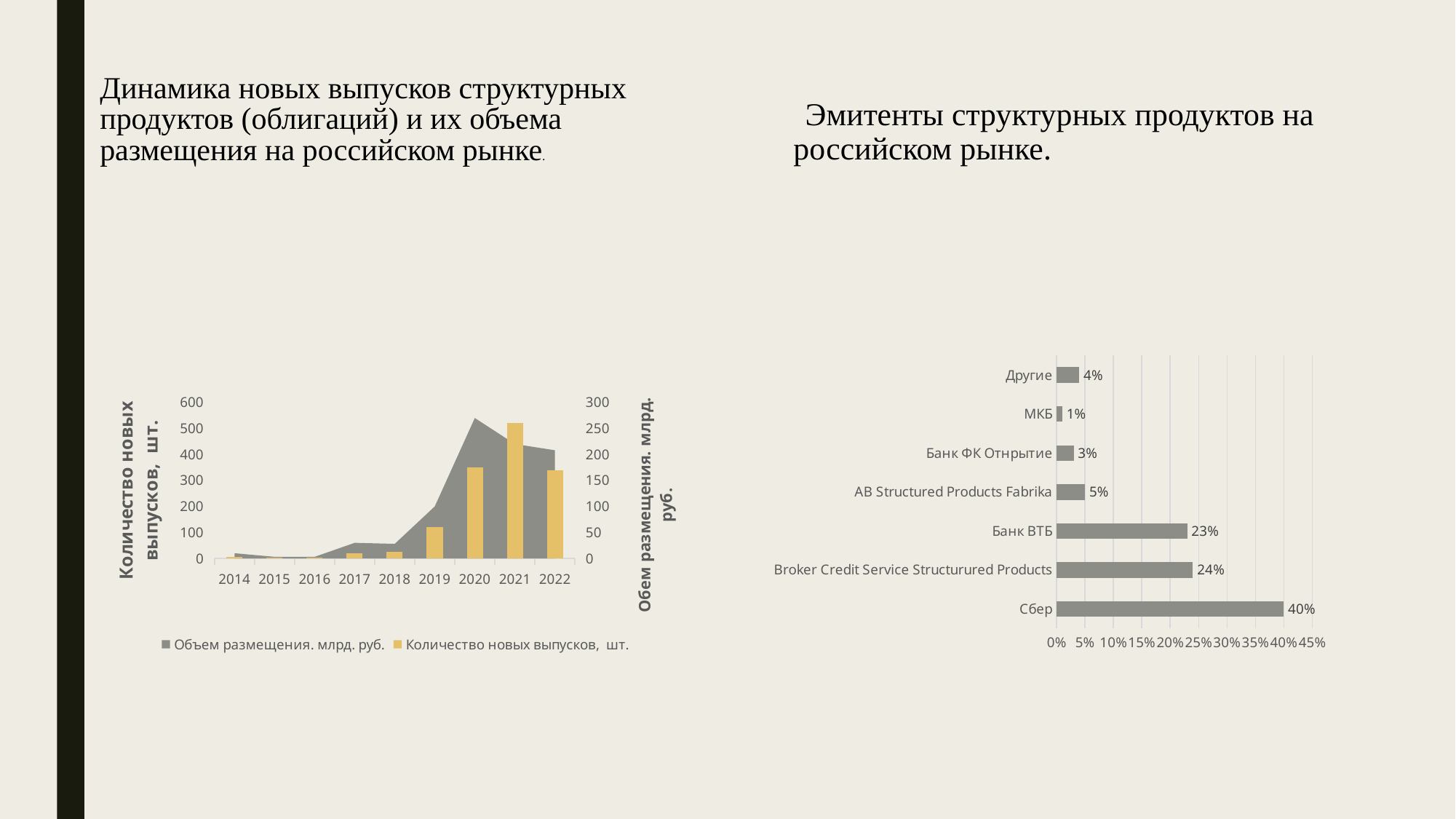
In the chart titled "Эмитенты структурных продуктов на российском рынке", which issuer has the highest share? Сбер In the chart titled "Эмитенты структурных продуктов на российском рынке", what is the value for Сбер? 40% In the chart on the left of the slide, how many series does the legend list? 2 In the chart titled "Эмитенты структурных продуктов на российском рынке", which is larger: Broker Credit Service Structurured Products or Банк ВТБ? Broker Credit Service Structurured Products In the chart titled "Эмитенты структурных продуктов на российском рынке", what is the value for МКБ? 1% In the chart titled "Эмитенты структурных продуктов на российском рынке", which issuer has the lowest share? МКБ In the chart titled "Эмитенты структурных продуктов на российском рынке", how many issuer categories are shown? 7 In the chart titled "Эмитенты структурных продуктов на российском рынке", what is the value for Банк ВТБ? 23% In the chart titled "Эмитенты структурных продуктов на российском рынке", what is the difference between the values for Сбер and Broker Credit Service Structurured Products? 16% In the chart on the left of the slide, in which year does the "Объем размещения, млрд. руб." area reach its peak? 2020 In the chart on the left of the slide, in which year is the bar for "Количество новых выпусков, шт." the tallest? 2021 What kind of chart is the one titled "Эмитенты структурных продуктов на российском рынке"? Bar chart